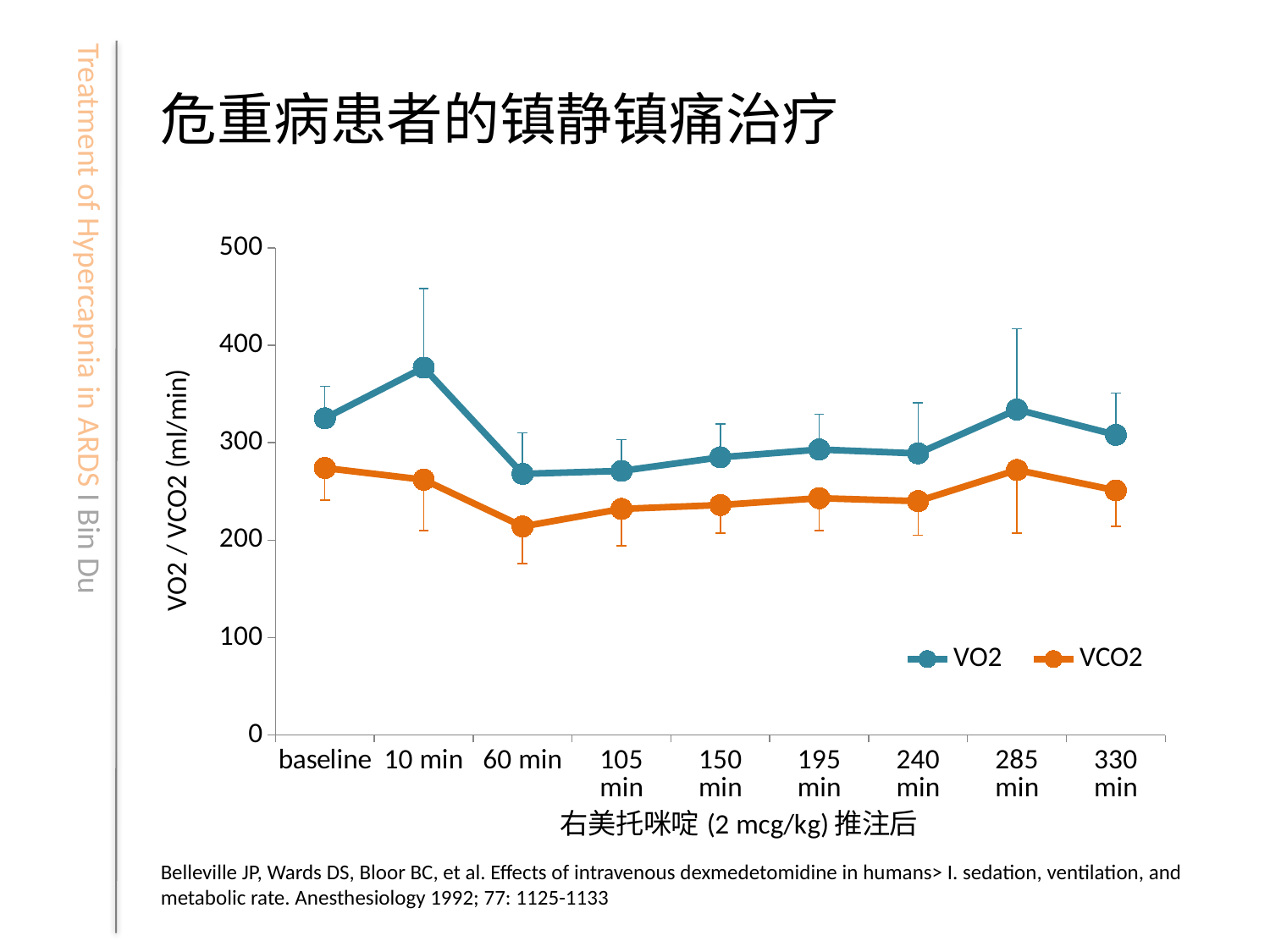
How many series does the legend list? 2 Is the VO2 value at 10 min greater or less than 300? greater How many time points are plotted along the x axis? 9 Is the VCO2 value at 330 min greater or less than 300? less Is the VCO2 value at 60 min greater or less than 300? less At baseline, which series has the larger value, VO2 or VCO2? VO2 At which time point is the VCO2 value lowest? 60 min What kind of chart is shown on the slide? line chart What is the label of the y axis? VO2 / VCO2 (ml/min) At which time point is the VO2 value highest? 10 min Does the VO2 value rise or fall from 10 min to 60 min? fall